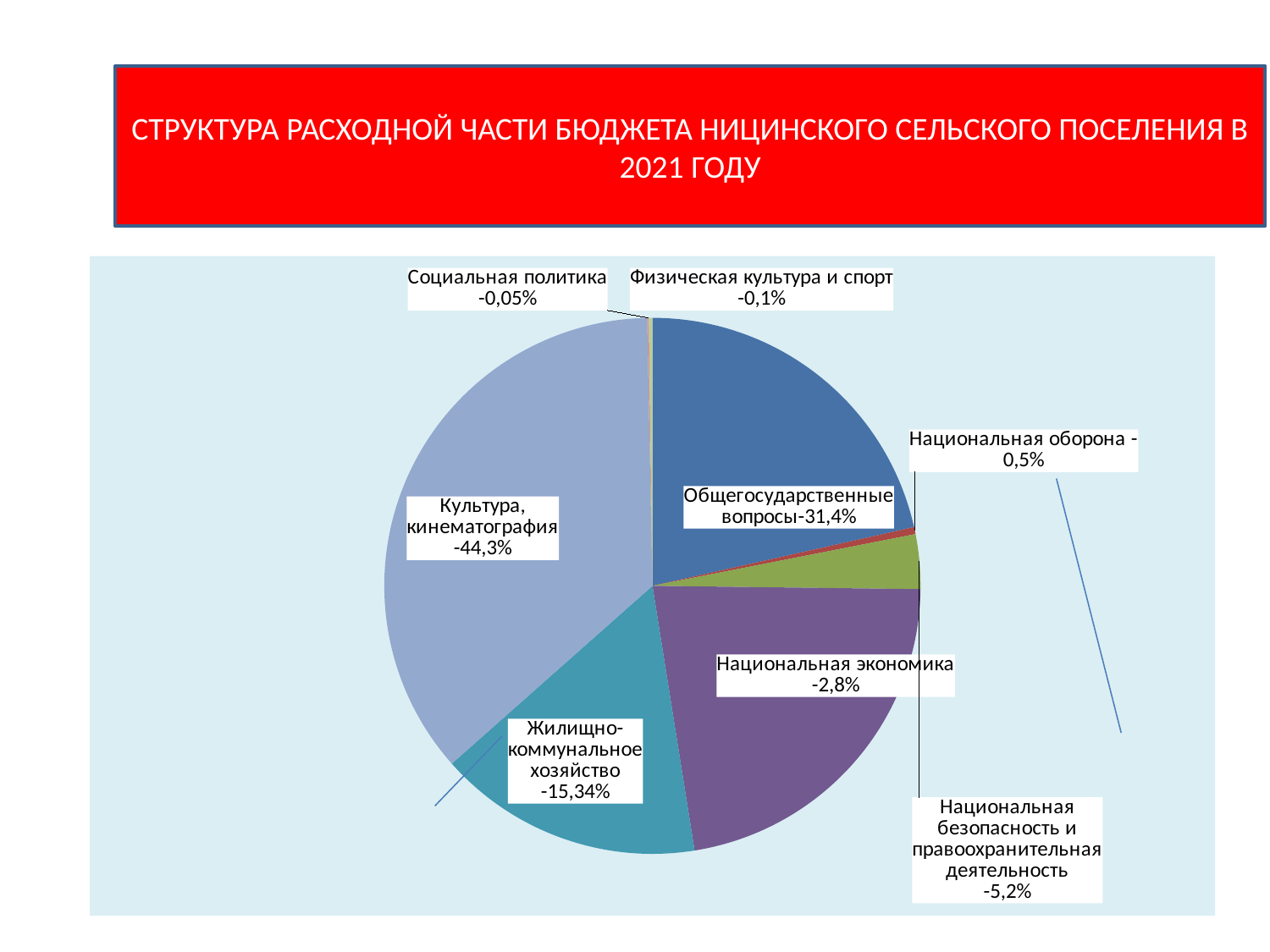
What share is labelled for Национальная оборона? 0,5% What share is labelled for Жилищно-коммунальное хозяйство? 15,34% What share is labelled for Национальная безопасность и правоохранительная деятельность? 5,2% How many categories are shown in the pie chart? 8 Which category has the smallest share of the pie? Социальная политика What is the difference between the shares of Культура, кинематография and Общегосударственные вопросы? 12,9% Which category has the largest share of the pie? Культура, кинематография What share of the budget expenditure is labelled for Культура, кинематография? 44,3% What share is labelled for Общегосударственные вопросы? 31,4% Which is larger: the share for Национальная экономика or the share for Физическая культура и спорт? Национальная экономика What kind of chart is shown on the slide? pie chart What year does the chart title say the budget expenditure structure refers to? 2021